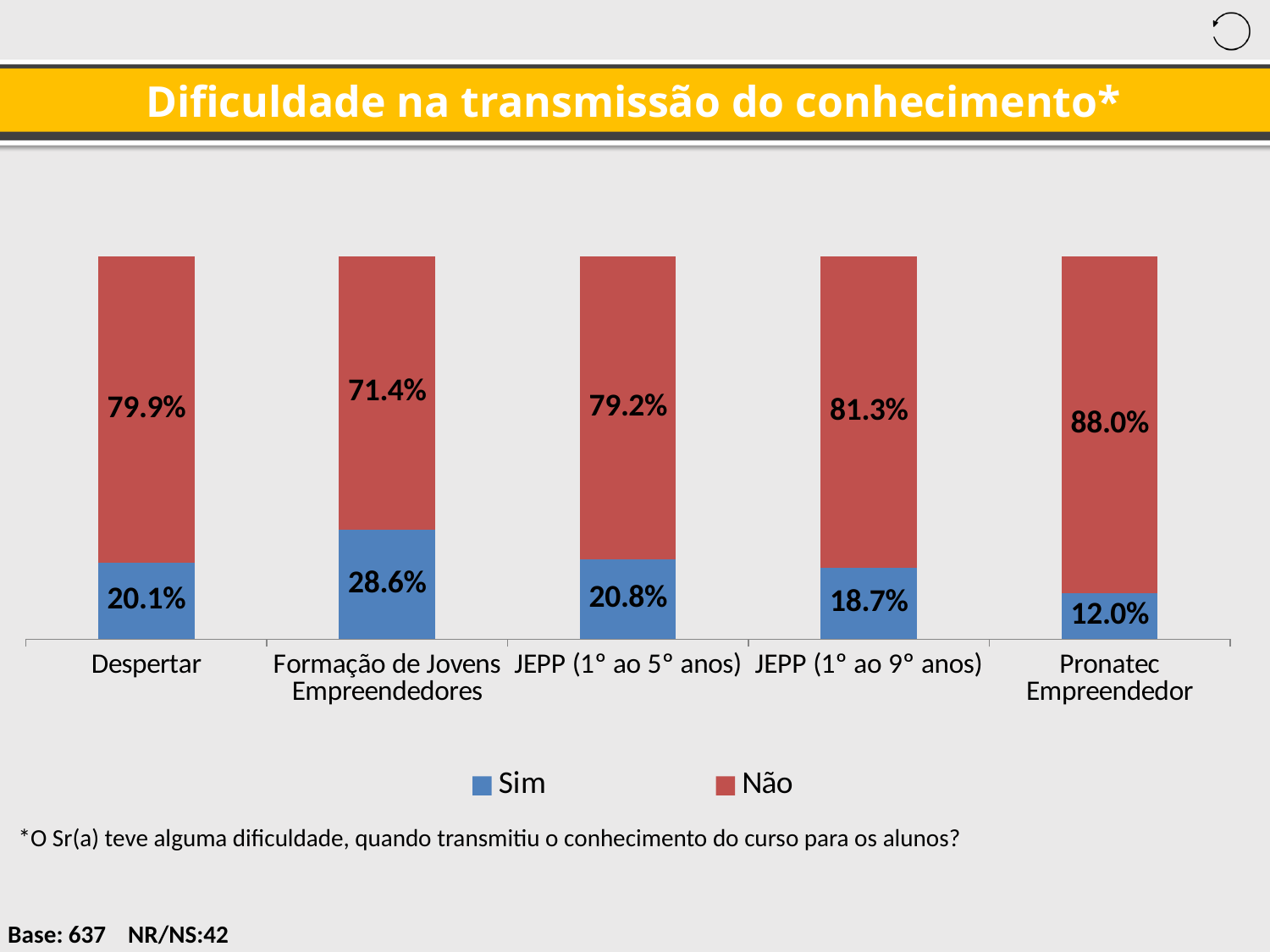
Which is larger: the 'Sim' value for JEPP (1° ao 5° anos) or for JEPP (1° ao 9° anos)? JEPP (1° ao 5° anos) What is the 'Não' value for JEPP (1° ao 9° anos)? 81.3% What is the difference between the 'Não' values for Pronatec Empreendedor and Formação de Jovens Empreendedores? 16.6% Which category has the lowest 'Sim' value? Pronatec Empreendedor What is the 'Não' value for Pronatec Empreendedor? 88.0% How many series does the legend list? 2 How many categories are shown on the x axis? 5 What is the total of the stacked bar for Despertar? 100.0% What is the 'Sim' value for Formação de Jovens Empreendedores? 28.6% What is the 'Sim' value for Despertar? 20.1% Which category has the highest 'Sim' value? Formação de Jovens Empreendedores What kind of chart is shown on the slide? Stacked bar chart